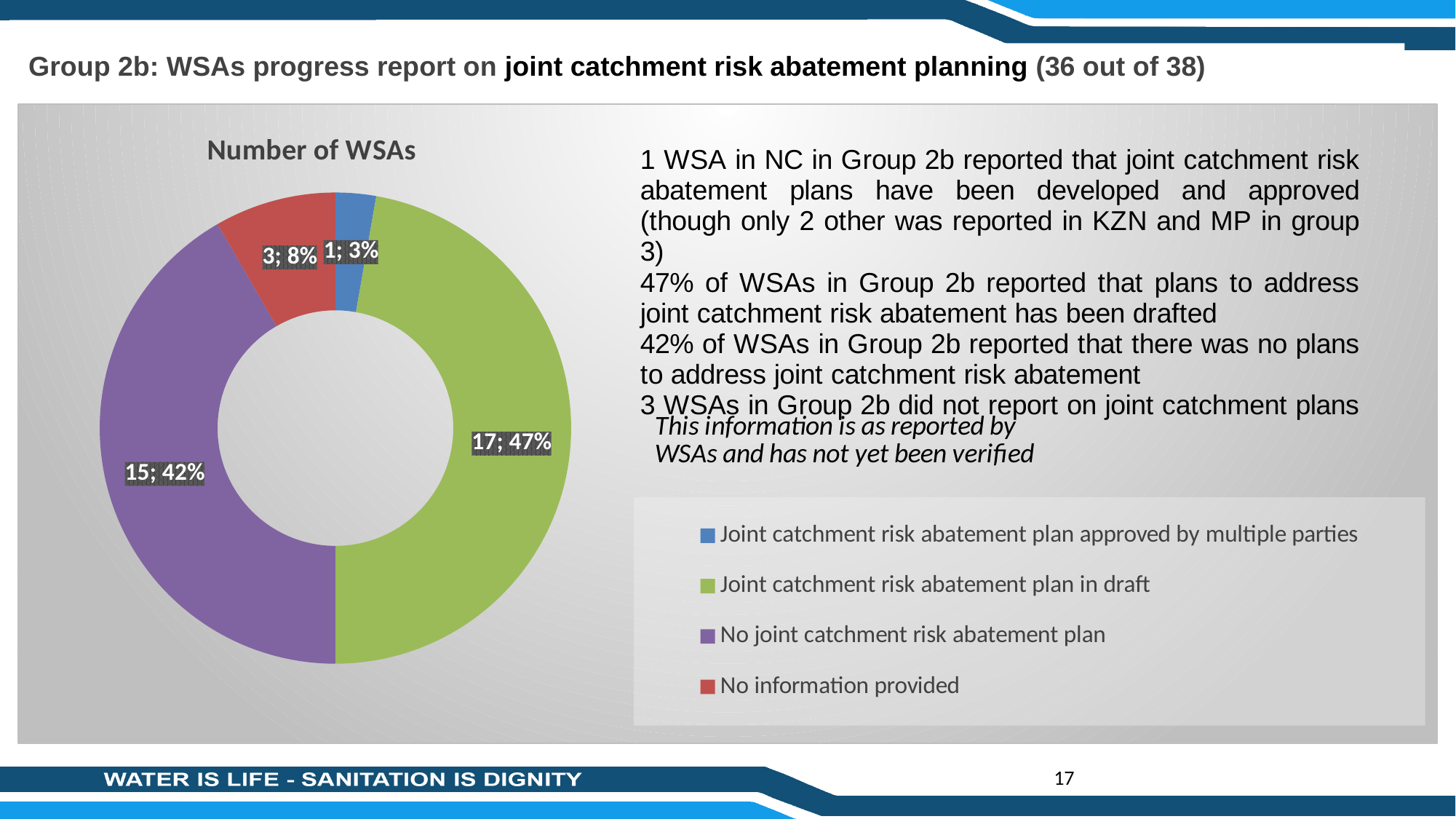
Which category has the largest number of WSAs? Joint catchment risk abatement plan in draft How many WSAs provided no information? 3 What is the difference between the number of WSAs with a plan in draft and those with no plan? 2 How many WSAs reported a joint catchment risk abatement plan in draft? 17 Which category has the smallest number of WSAs? Joint catchment risk abatement plan approved by multiple parties What share of WSAs reported a joint catchment risk abatement plan in draft? 47% What is the title of the chart? Number of WSAs What share of WSAs reported no joint catchment risk abatement plan? 42% How many WSAs reported no joint catchment risk abatement plan? 15 How many WSAs reported a joint catchment risk abatement plan approved by multiple parties? 1 How many categories does the legend list? 4 What type of chart is shown on the slide? Doughnut (pie) chart